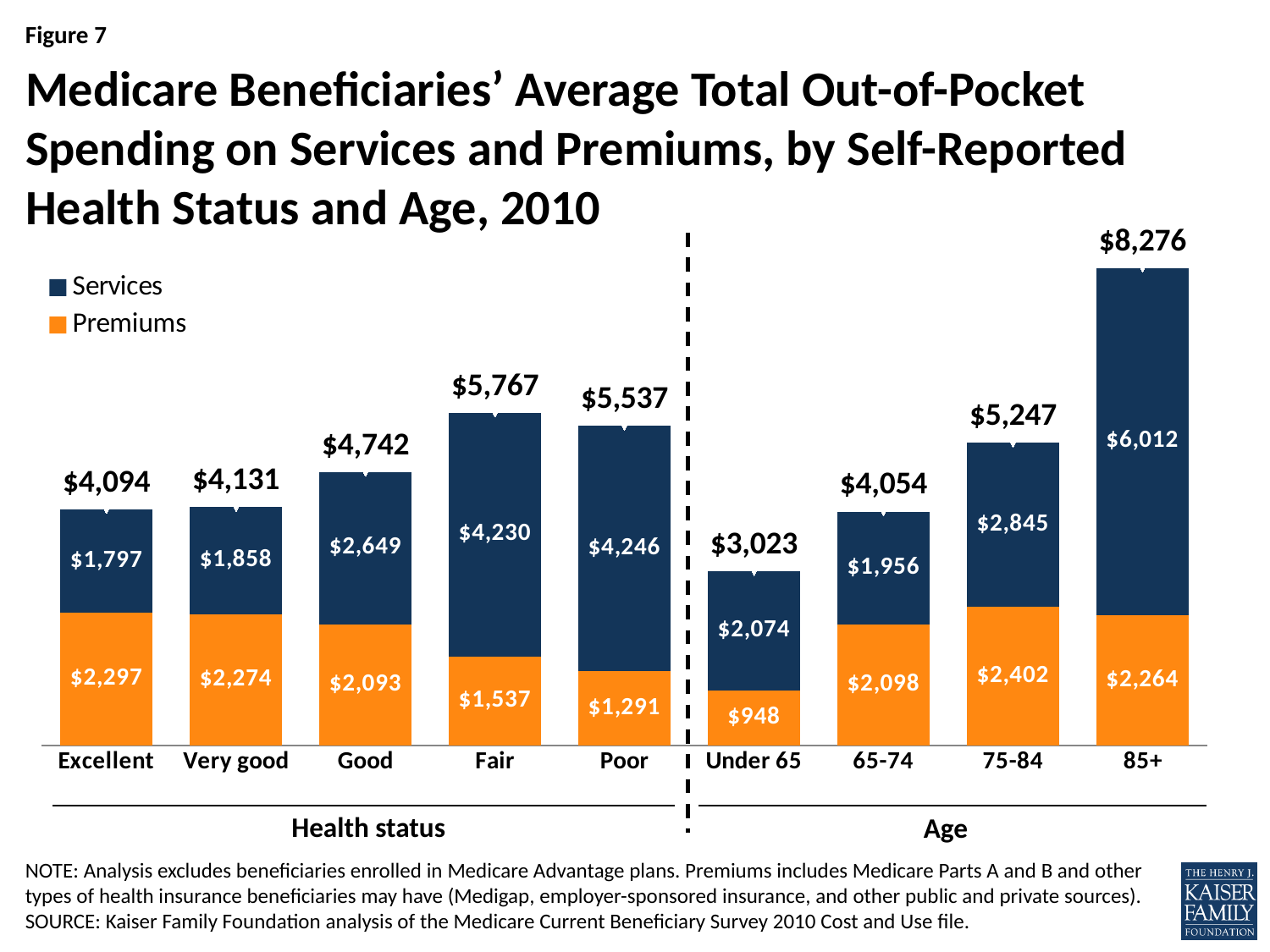
How many categories are shown on the x axis? 9 Which category has the highest total out-of-pocket spending? 85+ What is the Premiums value for the Fair health status category? $1,537 How many series does the legend list? 2 Which series is shown in orange? Premiums Which category has the lowest total out-of-pocket spending? Under 65 Across the age groups from Under 65 to 85+, do the total values rise or fall? Rise What is the difference between the total spending for Poor and Excellent health status? $1,443 What is the total out-of-pocket spending shown for the Under 65 age group? $3,023 What kind of chart is shown on the slide? Stacked bar chart What is the Services value for beneficiaries aged 85+? $6,012 Which is larger, the Services value for Good health status or the Services value for the 65-74 age group? Good health status